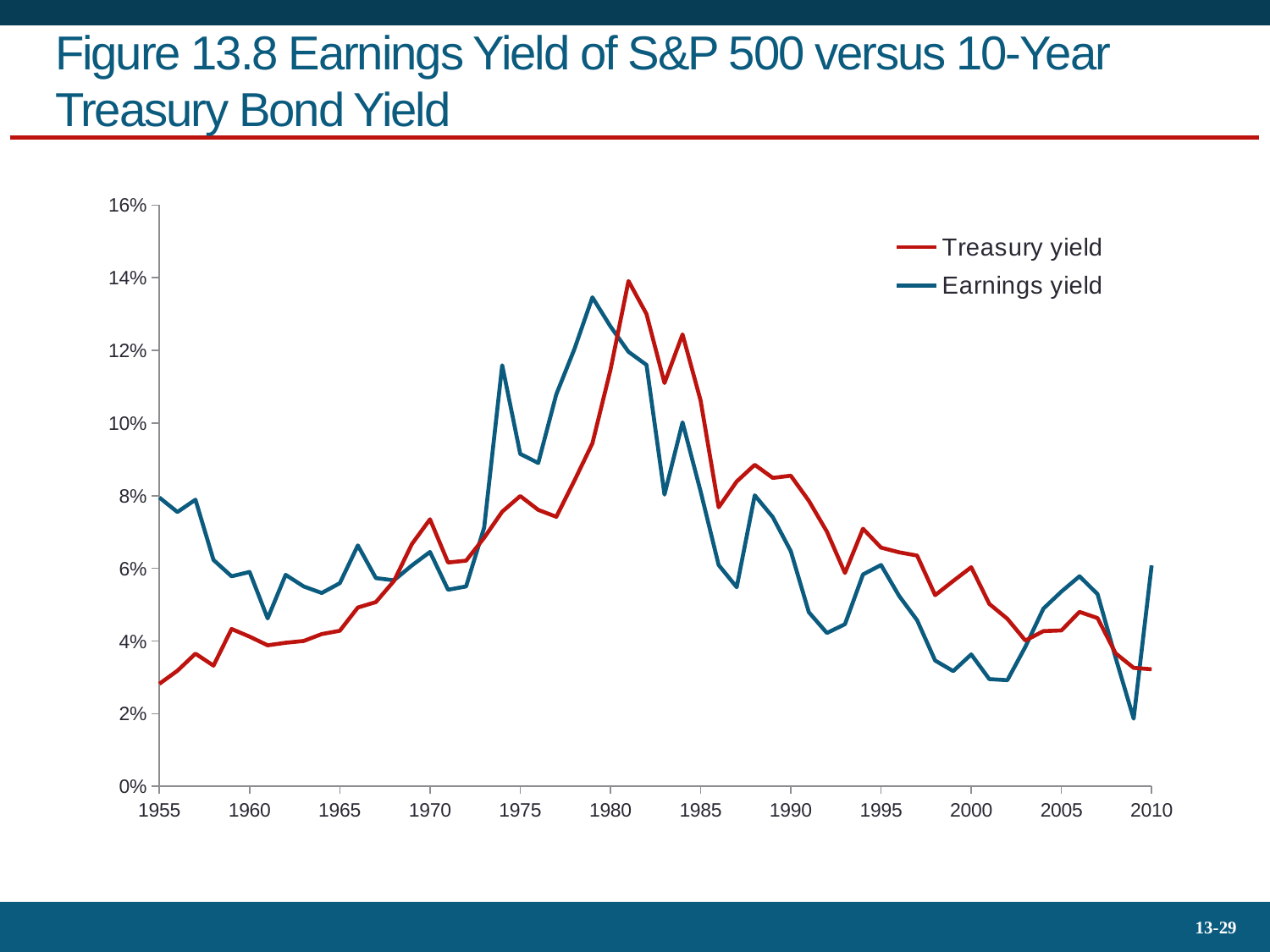
In which year does the Treasury yield reach its highest value? 1981 Which series is drawn in red? Treasury yield In 2010, which is higher, the Treasury yield or the Earnings yield? Earnings yield How many series does the legend list? 2 Does the Treasury yield generally rise or fall from 1981 to 2010? Fall In which year does the Earnings yield reach its highest value? 1979 Is the Treasury yield in 1955 greater or less than 4%? less In which year is the Earnings yield at its lowest? 2009 What kind of chart is shown on the slide? Line chart In 1955, which is higher, the Treasury yield or the Earnings yield? Earnings yield Is the Treasury yield in 1981 greater or less than 12%? greater Is the Earnings yield in 2009 greater or less than 4%? less